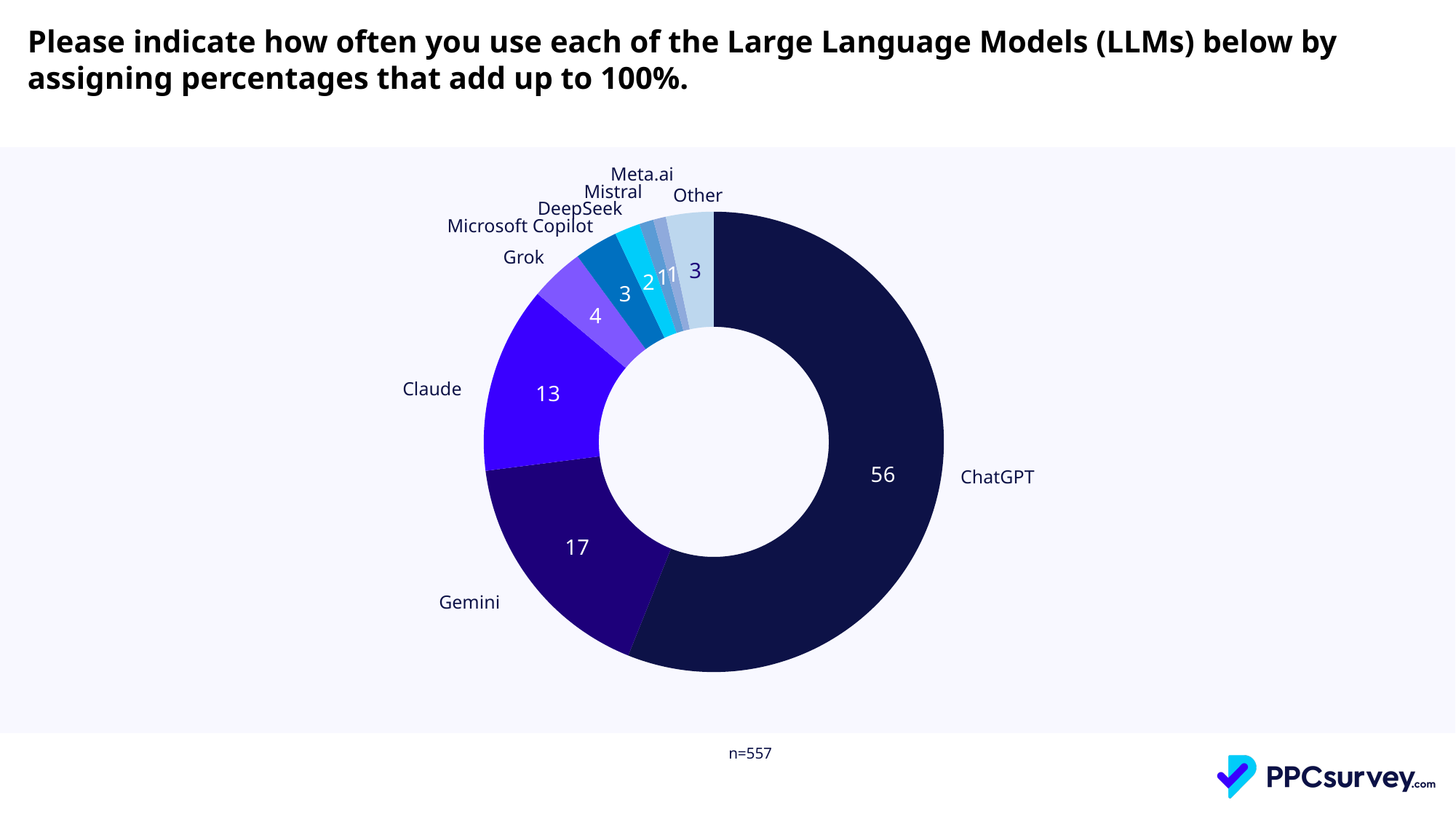
What is the difference between the values for ChatGPT and Gemini? 39 Which is larger, the value for Gemini or the value for Claude? Gemini Which LLM has the largest share of the chart? ChatGPT What percentage is shown for ChatGPT? 56 What value is shown for Grok? 4 How many categories are shown in the chart? 9 What value is shown for DeepSeek? 2 What value is shown for Microsoft Copilot? 3 What kind of chart is shown on the slide? doughnut chart What value is shown for Gemini? 17 What value is shown for Claude? 13 What sample size (n) is stated below the chart? n=557